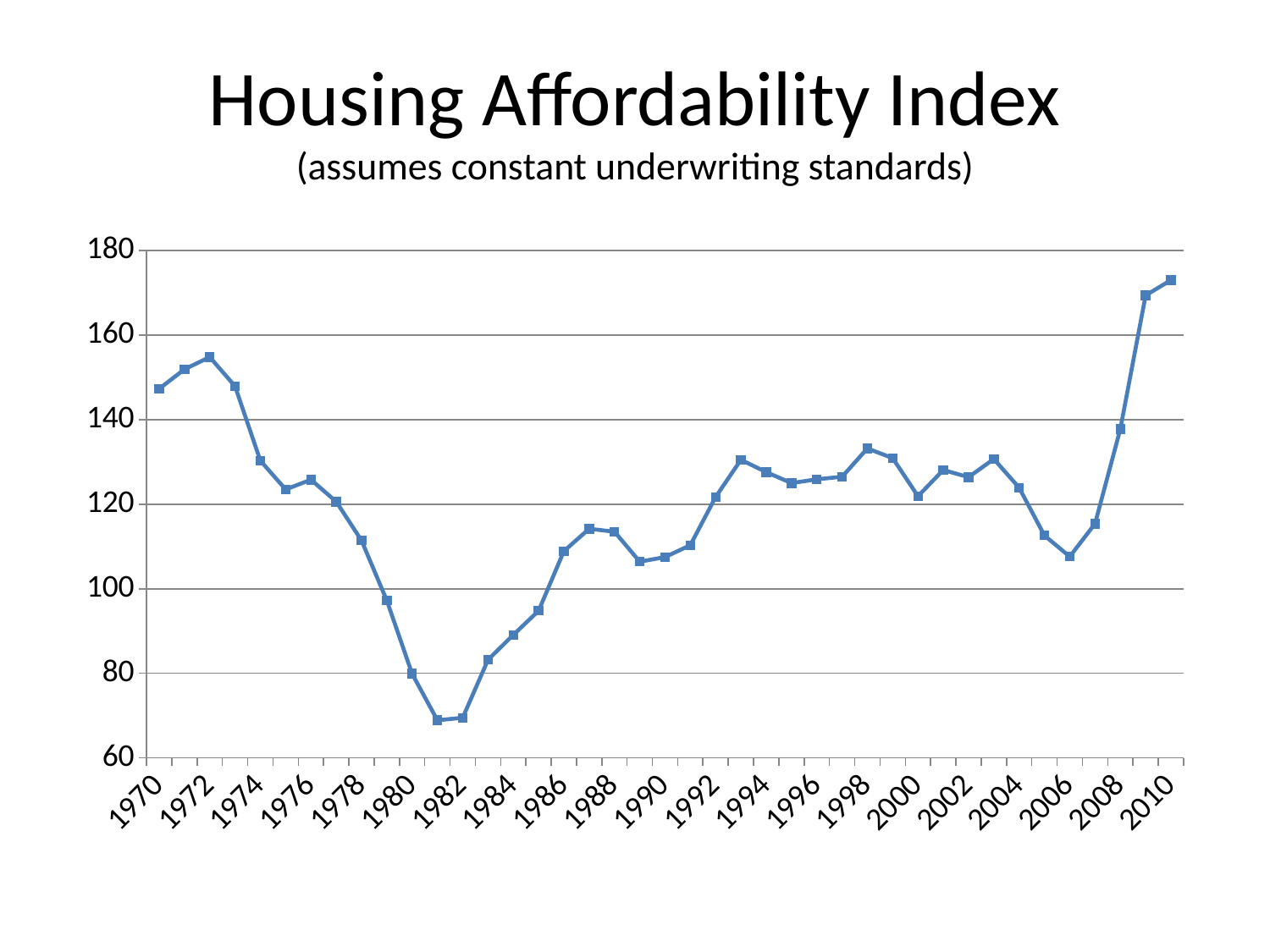
Is the value for 2006 greater or less than 120? less Which year has the highest value on the chart? 2010 What is the title of the chart on the slide? Housing Affordability Index What kind of chart is shown on the slide? line chart What assumption is stated in the subtitle under the chart title? assumes constant underwriting standards Is the value for 2009 greater or less than 160? greater Which is larger, the value for 1982 or the value for 1986? 1986 Do the values rise or fall from 2006 to 2010? rise Is the value for 1981 greater or less than 80? less Which is larger, the value for 1994 or the value for 2006? 1994